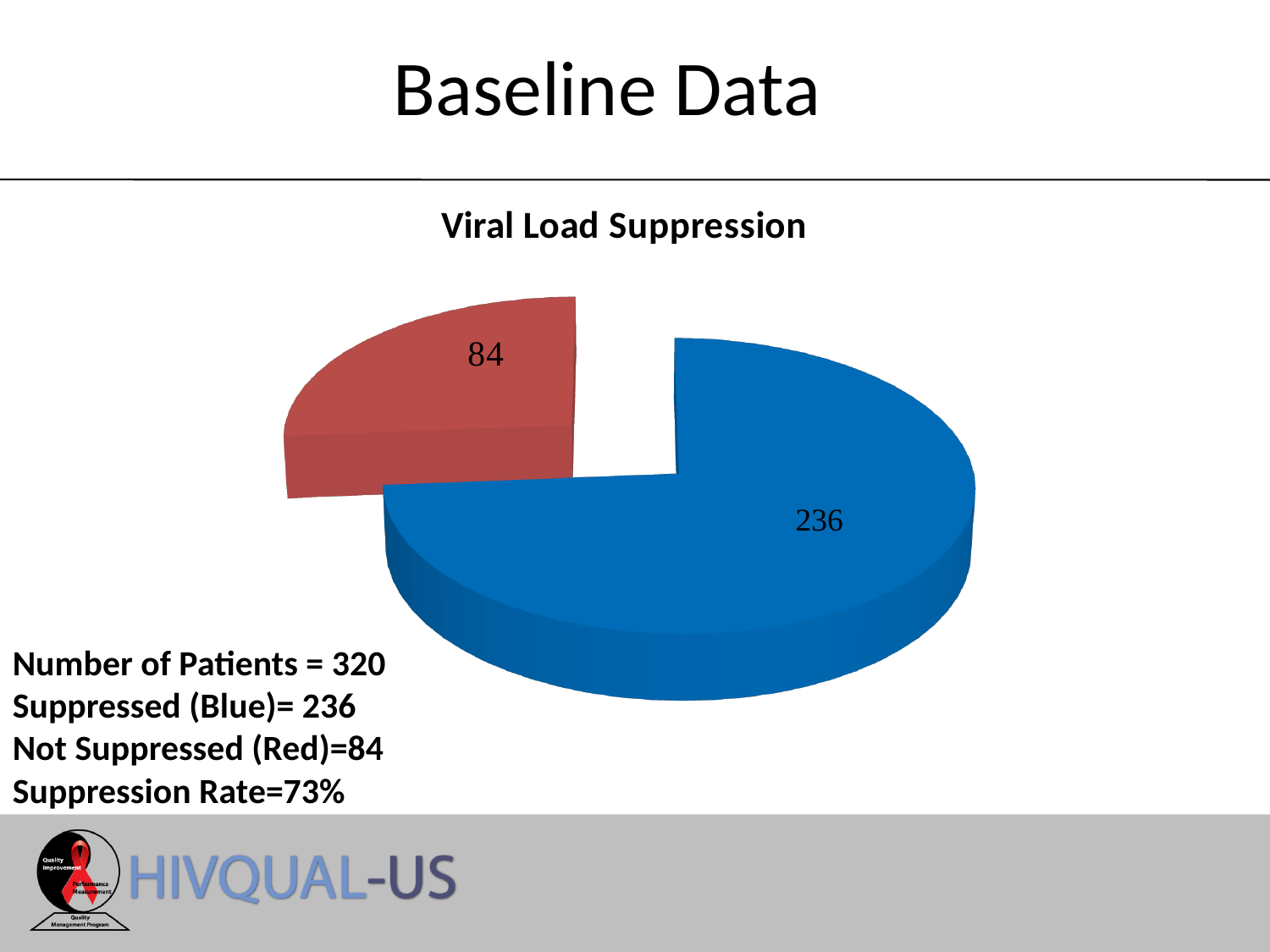
What is the difference between the Suppressed and Not Suppressed values? 152 What type of chart is shown on the slide? Pie chart Which slice is the smallest in the pie chart? Not Suppressed (Red) What is the value of the blue (Suppressed) slice? 236 What colour is the Not Suppressed slice? Red What suppression rate does the slide state for the blue slice? 73% How many slices does the pie chart have? 2 Which is larger, the Suppressed value or the Not Suppressed value? Suppressed Which slice is the largest in the pie chart? Suppressed (Blue) What is the title of the chart? Viral Load Suppression What is the total of the two slices in the pie chart? 320 What is the value of the red (Not Suppressed) slice? 84